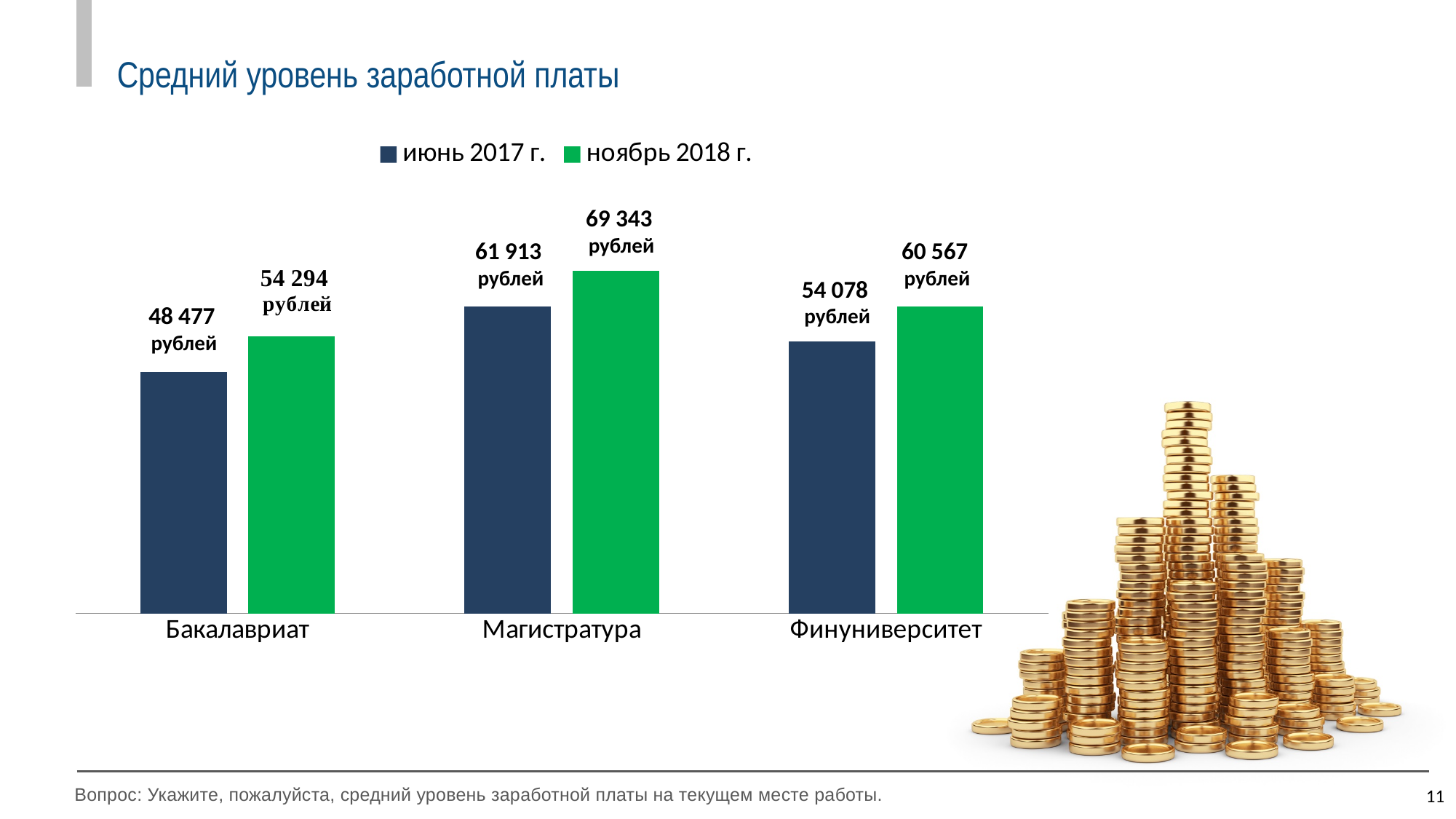
What is the title of the chart? Средний уровень заработной платы What is the value for Магистратура in the ноябрь 2018 г. series? 69 343 рублей What is the value for Бакалавриат in the июнь 2017 г. series? 48 477 рублей What is the difference between the ноябрь 2018 г. and июнь 2017 г. values for Бакалавриат? 5 817 рублей How many series does the legend list? 2 Which is larger: the ноябрь 2018 г. value for Финуниверситет or the июнь 2017 г. value for Магистратура? июнь 2017 г. value for Магистратура Which category has the highest value in the ноябрь 2018 г. series? Магистратура What is the value for Финуниверситет in the июнь 2017 г. series? 54 078 рублей What kind of chart is shown on the slide? Bar chart How many categories are shown on the x axis? 3 What is the difference between the ноябрь 2018 г. and июнь 2017 г. values for Магистратура? 7 430 рублей Which category has the lowest value in the июнь 2017 г. series? Бакалавриат